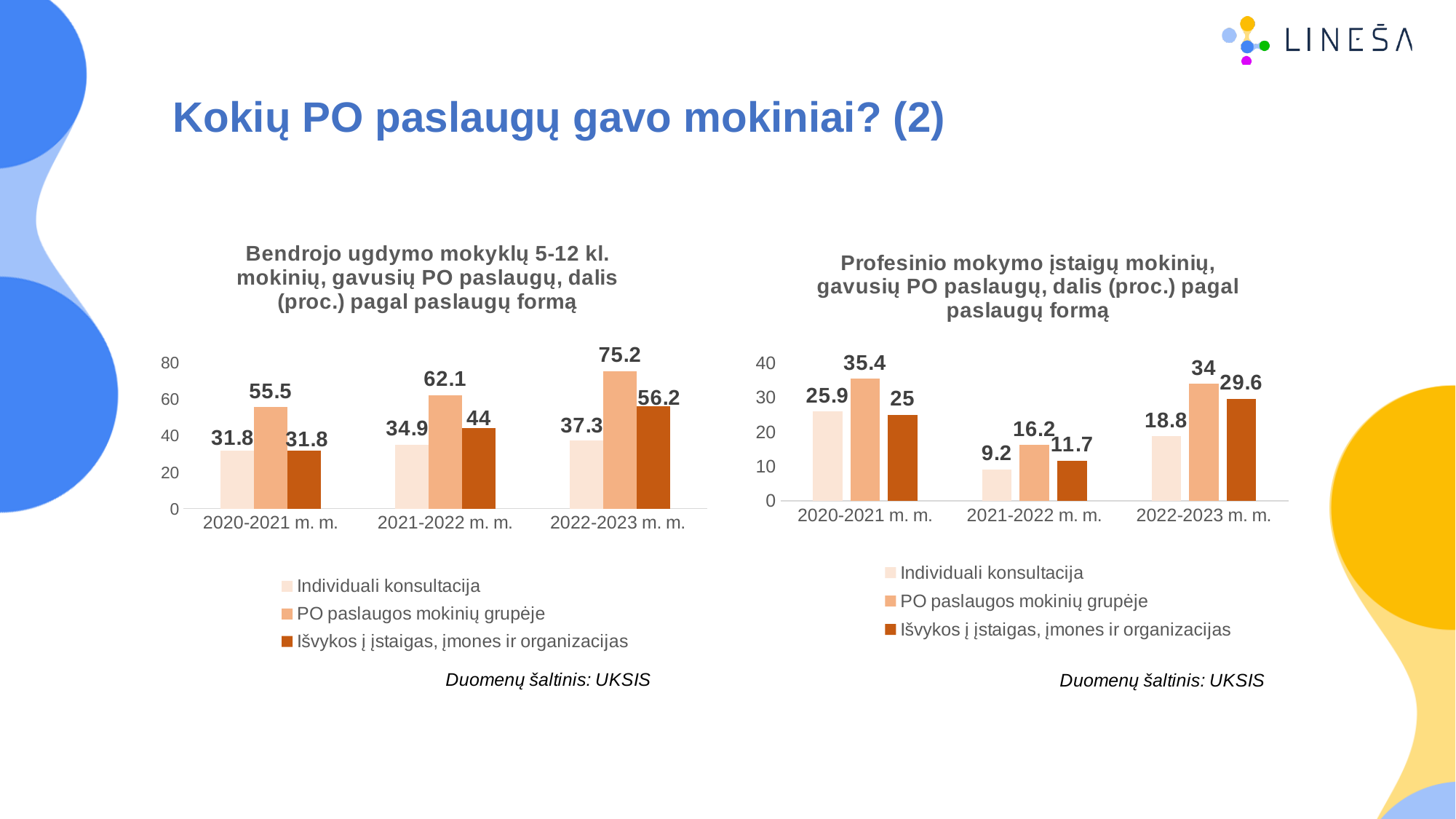
How many series does the legend of the left chart (Bendrojo ugdymo mokyklų 5-12 kl.) list? 3 In the left chart (Bendrojo ugdymo mokyklų 5-12 kl.), what is the value for PO paslaugos mokinių grupėje in 2022-2023 m. m.? 75.2 In the right chart (Profesinio mokymo įstaigų mokinių), which school year has the lowest value for Išvykos į įstaigas, įmones ir organizacijas? 2021-2022 m. m. What kind of chart is the right chart (Profesinio mokymo įstaigų mokinių)? Bar chart In the left chart (Bendrojo ugdymo mokyklų 5-12 kl.), which school year has the highest value for PO paslaugos mokinių grupėje? 2022-2023 m. m. In the left chart (Bendrojo ugdymo mokyklų 5-12 kl.), what is the difference between PO paslaugos mokinių grupėje and Individuali konsultacija in 2022-2023 m. m.? 37.9 In the left chart (Bendrojo ugdymo mokyklų 5-12 kl.), does the value for Individuali konsultacija rise or fall from 2020-2021 m. m. to 2022-2023 m. m.? Rise In the left chart (Bendrojo ugdymo mokyklų 5-12 kl.), what is the value for Išvykos į įstaigas, įmones ir organizacijas in 2021-2022 m. m.? 44 In the right chart (Profesinio mokymo įstaigų mokinių), what is the value for Individuali konsultacija in 2021-2022 m. m.? 9.2 In the right chart (Profesinio mokymo įstaigų mokinių), which is larger in 2020-2021 m. m.: Individuali konsultacija or Išvykos į įstaigas, įmones ir organizacijas? Individuali konsultacija In the right chart (Profesinio mokymo įstaigų mokinių), what is the value for PO paslaugos mokinių grupėje in 2022-2023 m. m.? 34 In the right chart (Profesinio mokymo įstaigų mokinių), what is the difference between Individuali konsultacija in 2020-2021 m. m. and in 2021-2022 m. m.? 16.7